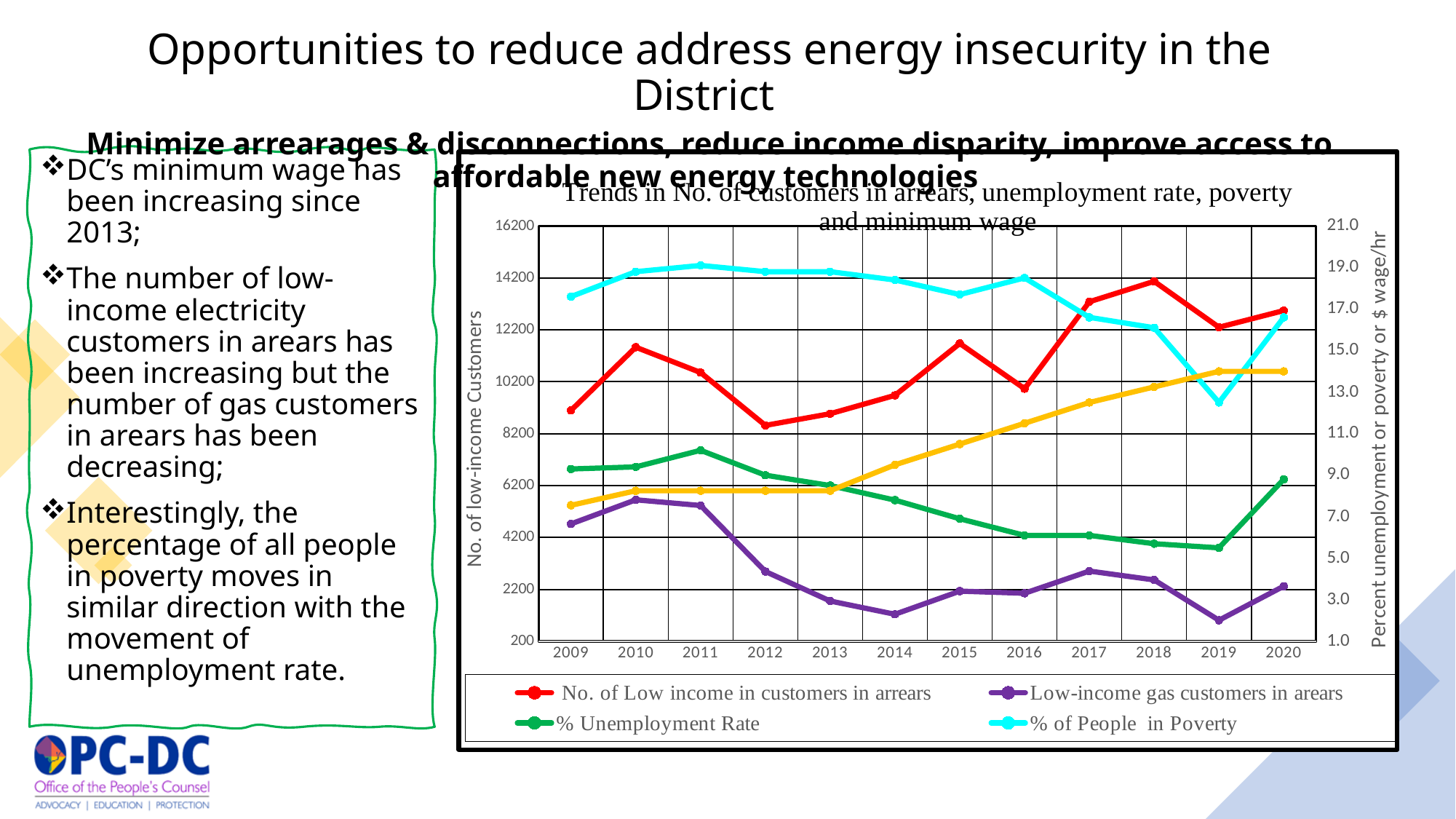
What kind of chart is shown on the slide? line chart Does the Low-income gas customers in arears series generally rise or fall from 2009 to 2019? fall Is the value for No. of Low income in customers in arrears in 2009 greater or less than 10200? less Which colour is used for the % Unemployment Rate series? green Is the value for No. of Low income in customers in arrears in 2018 greater or less than 12200? greater Is the % Unemployment Rate in 2019 greater or less than 7.0? less How many years are plotted along the x axis of the chart? 12 What is the title of the chart? Trends in No. of customers in arrears, unemployment rate, poverty and minimum wage In which year does the No. of Low income in customers in arrears series reach its highest value? 2018 How many series does the chart legend list? 4 Which is higher for No. of Low income in customers in arrears: 2015 or 2016? 2015